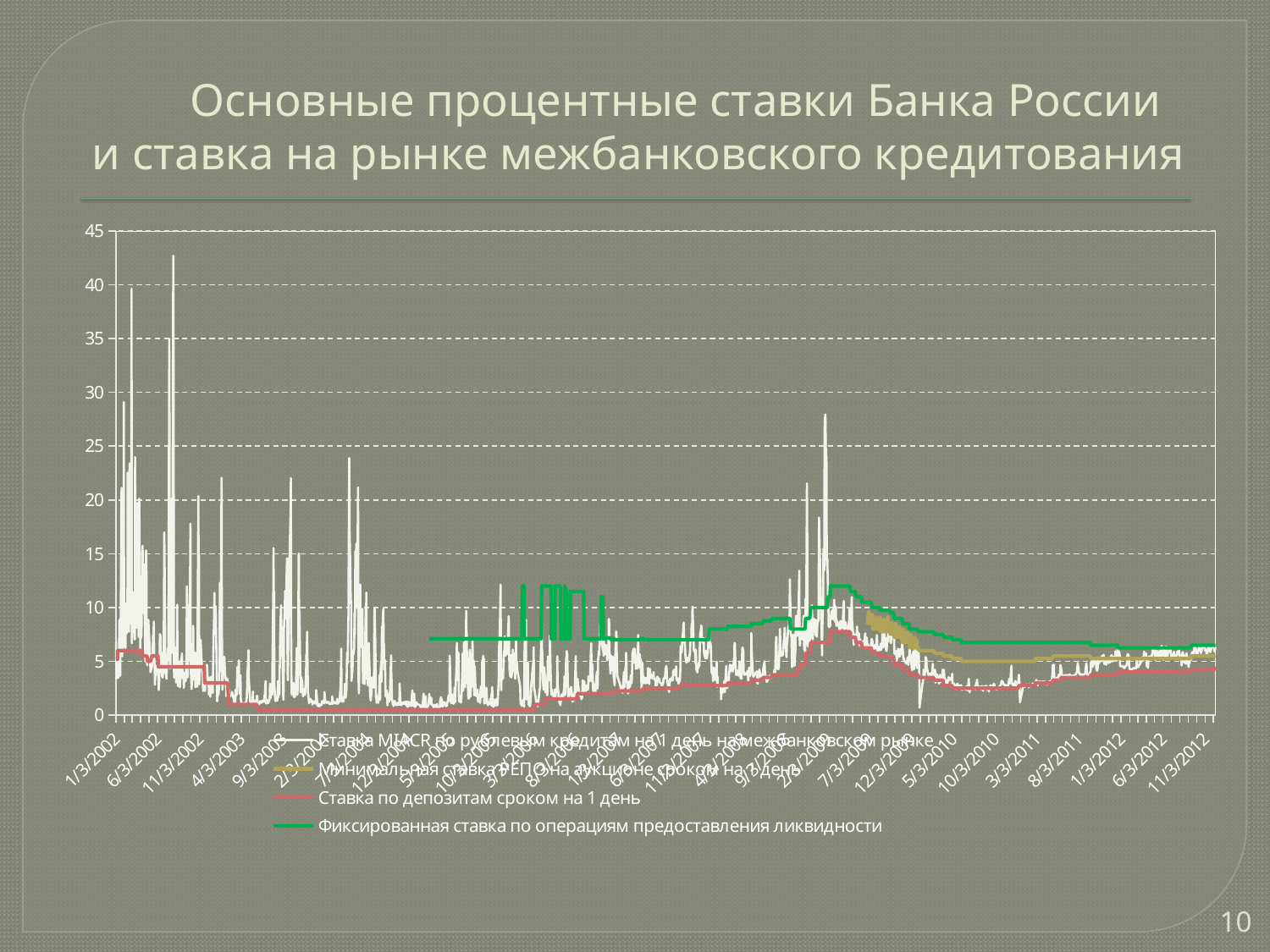
Does 'Ставка по депозитам сроком на 1 день' rise or fall between 7/3/2009 and 5/3/2010? fall What is the title of the slide containing the chart? Основные процентные ставки Банка России и ставка на рынке межбанковского кредитования Is the value of 'Фиксированная ставка по операциям предоставления ликвидности' at 11/3/2012 greater or less than 5? greater What is the maximum value shown on the vertical axis? 45 What kind of chart is shown on the slide? line chart Which series reaches the highest value anywhere on the chart? Ставка MIACR по рублевым кредитам на 1 день на межбанковском рынке Is the value of 'Фиксированная ставка по операциям предоставления ликвидности' at 11/3/2012 greater or less than 10? less How many series does the chart legend list? 4 At 11/3/2012, which is larger: 'Фиксированная ставка по операциям предоставления ликвидности' or 'Ставка по депозитам сроком на 1 день'? Фиксированная ставка по операциям предоставления ликвидности Is the value of 'Ставка по депозитам сроком на 1 день' at 1/3/2002 greater or less than 10? less Which colour is used for the series 'Фиксированная ставка по операциям предоставления ликвидности'? green